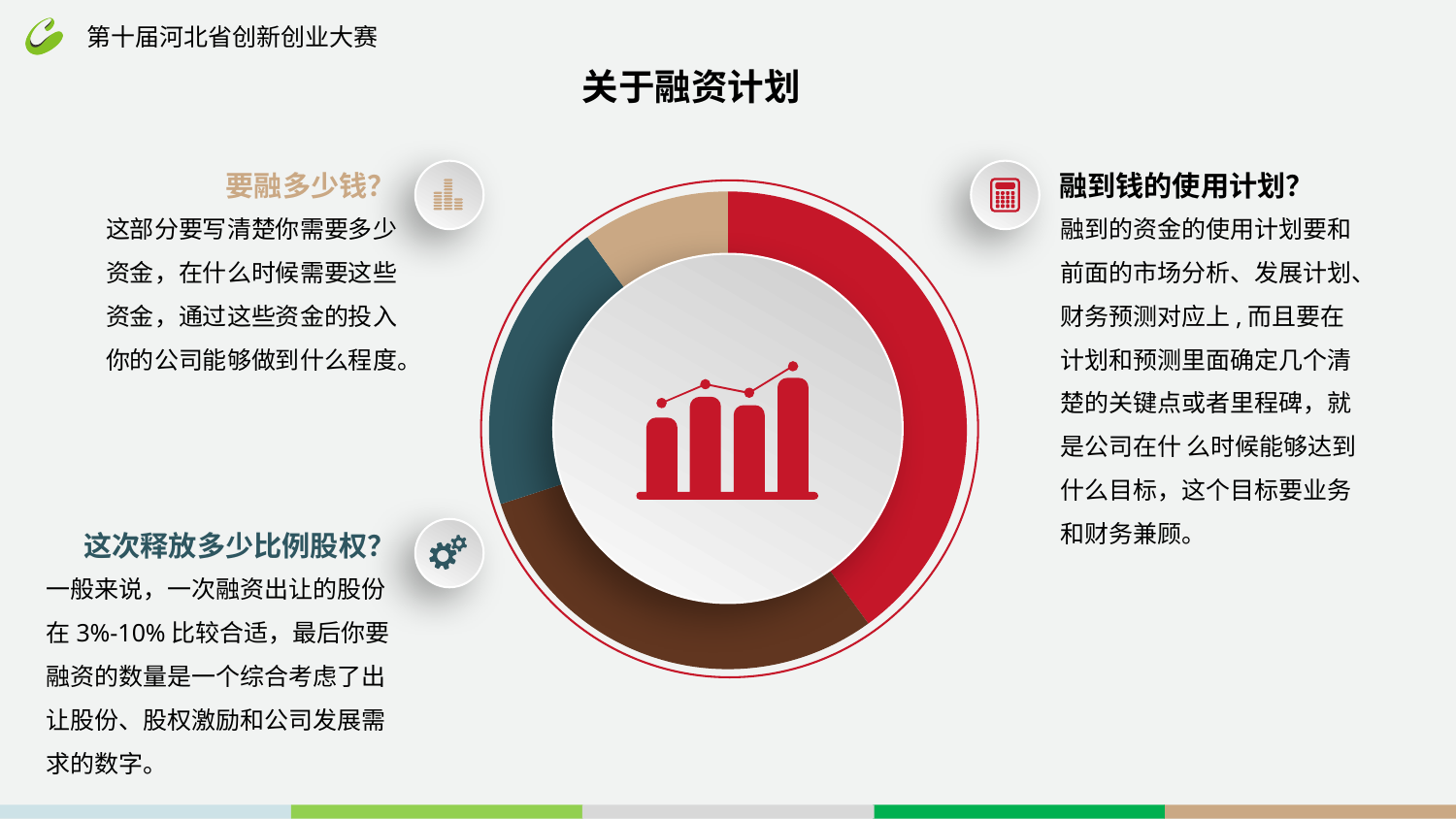
Which colour segment of the donut chart is the smallest? Tan (beige) Does the donut chart display any data labels or percentage values on its segments? No What colours are the four segments of the donut chart? Red, brown, teal and tan How many segments does the donut chart in the centre of the slide have? 4 In the donut chart, which segment is larger, the red one or the brown one? Red In the donut chart, which segment is larger, the teal one or the tan one? Teal Which colour segment of the donut chart is the largest? Red What kind of chart is shown in the centre of the slide? Pie (donut) chart